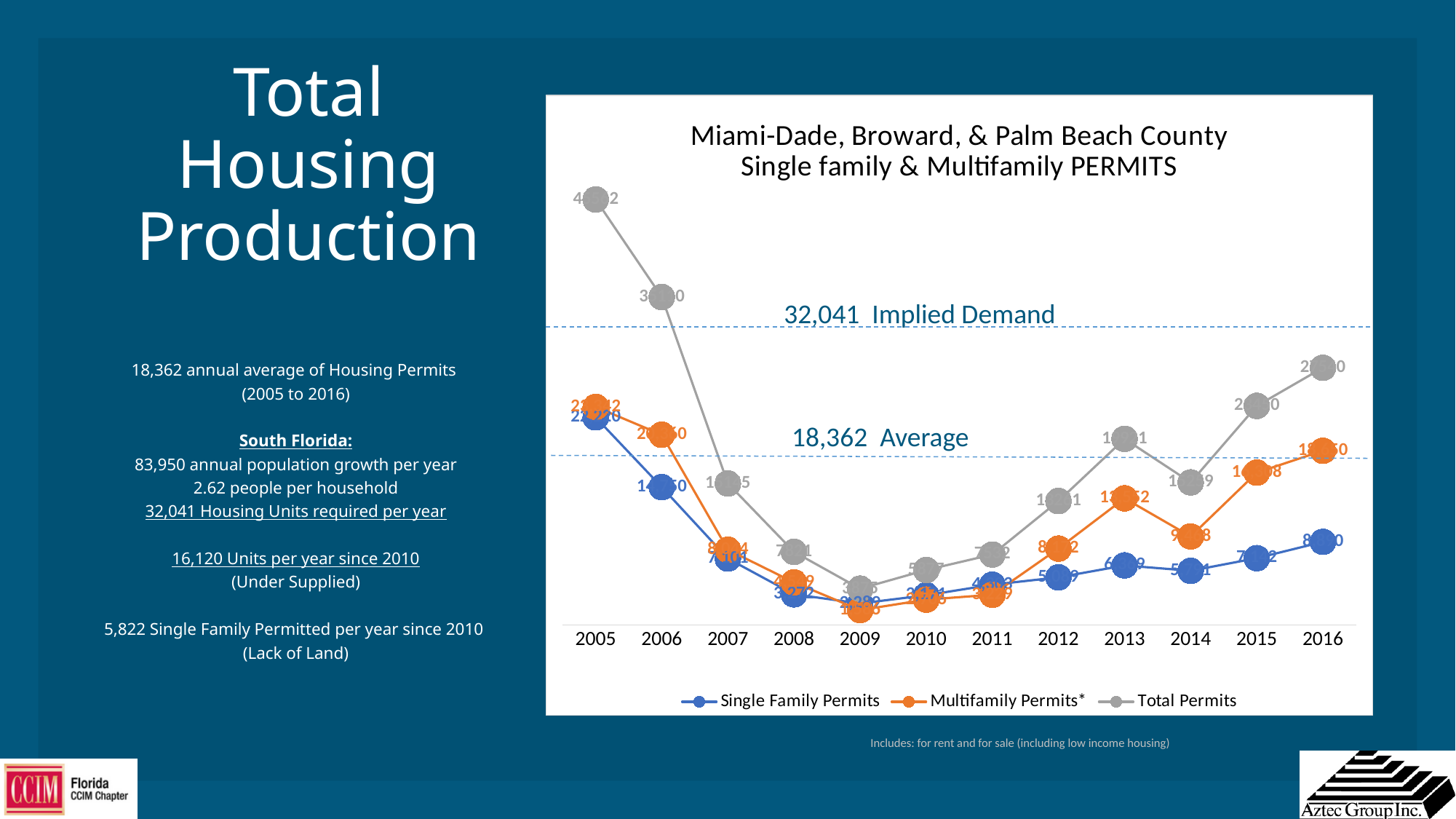
Do Total Permits rise or fall from 2009 to 2013? rise Is the value for Total Permits in 2005 greater or less than the 32,041 Implied Demand line? greater How many years are plotted along the x axis of the chart? 12 Do Total Permits rise or fall from 2005 to 2009? fall What kind of chart is shown on the slide? line chart In which year is Single Family Permits lowest? 2009 In which year is Total Permits highest? 2005 How many series does the chart legend list? 3 In which year is Total Permits lowest? 2009 What value is labelled as the Average reference line on the chart? 18,362 In 2016, which is larger: Single Family Permits or Multifamily Permits? Multifamily Permits Is the value for Total Permits in 2016 greater or less than the 32,041 Implied Demand line? less